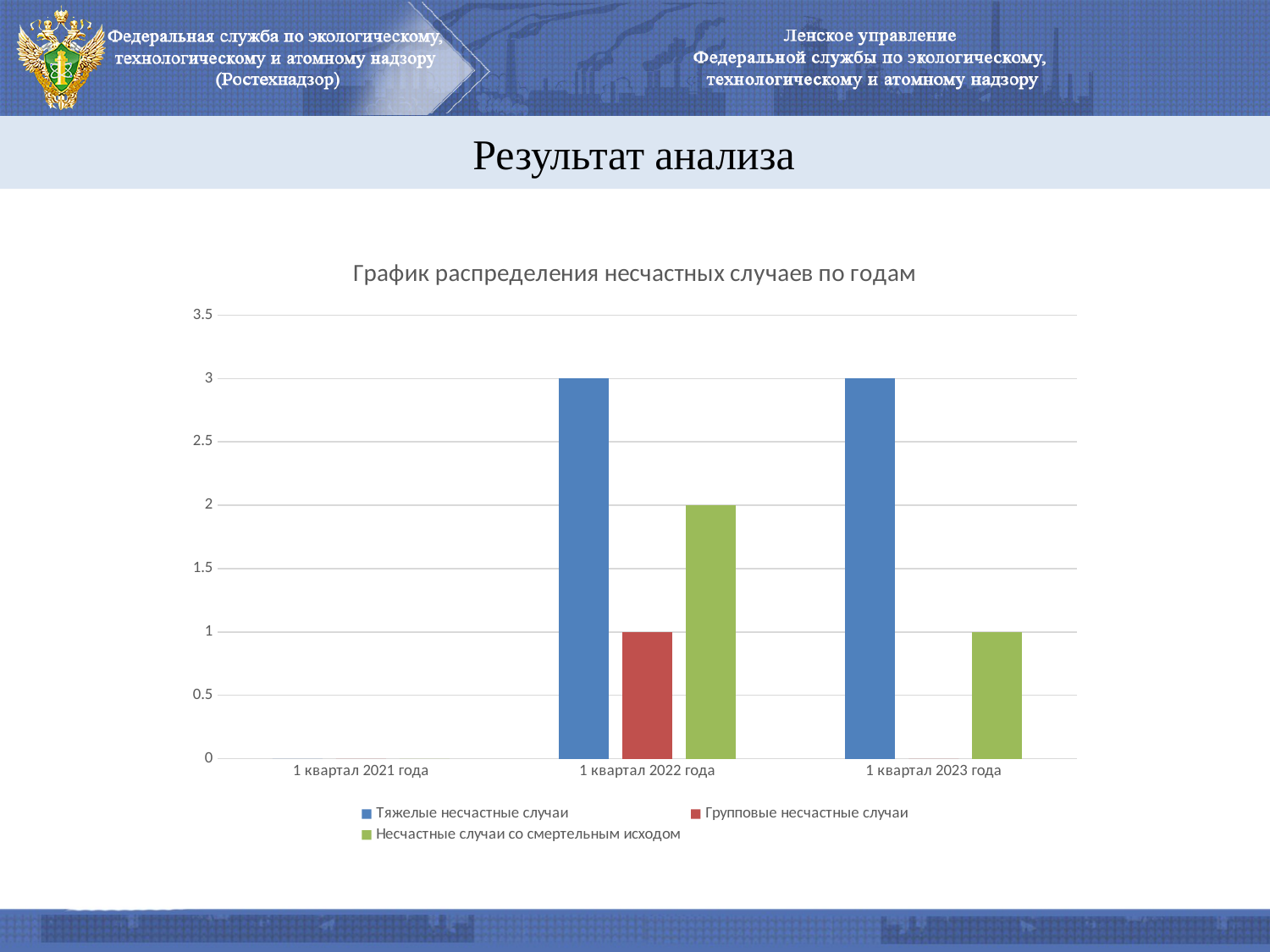
Which category has no bars plotted at all? 1 квартал 2021 года What is the title of the chart? График распределения несчастных случаев по годам How many series does the legend list? 3 What is the value of Несчастные случаи со смертельным исходом for 1 квартал 2023 года? 1 Which is larger: Тяжелые несчастные случаи or Несчастные случаи со смертельным исходом for 1 квартал 2023 года? Тяжелые несчастные случаи What is the value of Тяжелые несчастные случаи for 1 квартал 2022 года? 3 What is the value of Групповые несчастные случаи for 1 квартал 2022 года? 1 What is the value of Несчастные случаи со смертельным исходом for 1 квартал 2022 года? 2 Which series has the highest value for 1 квартал 2022 года? Тяжелые несчастные случаи How many categories are shown on the x axis? 3 What is the difference between Несчастные случаи со смертельным исходом for 1 квартал 2022 года and for 1 квартал 2023 года? 1 What kind of chart is shown on the slide? bar chart